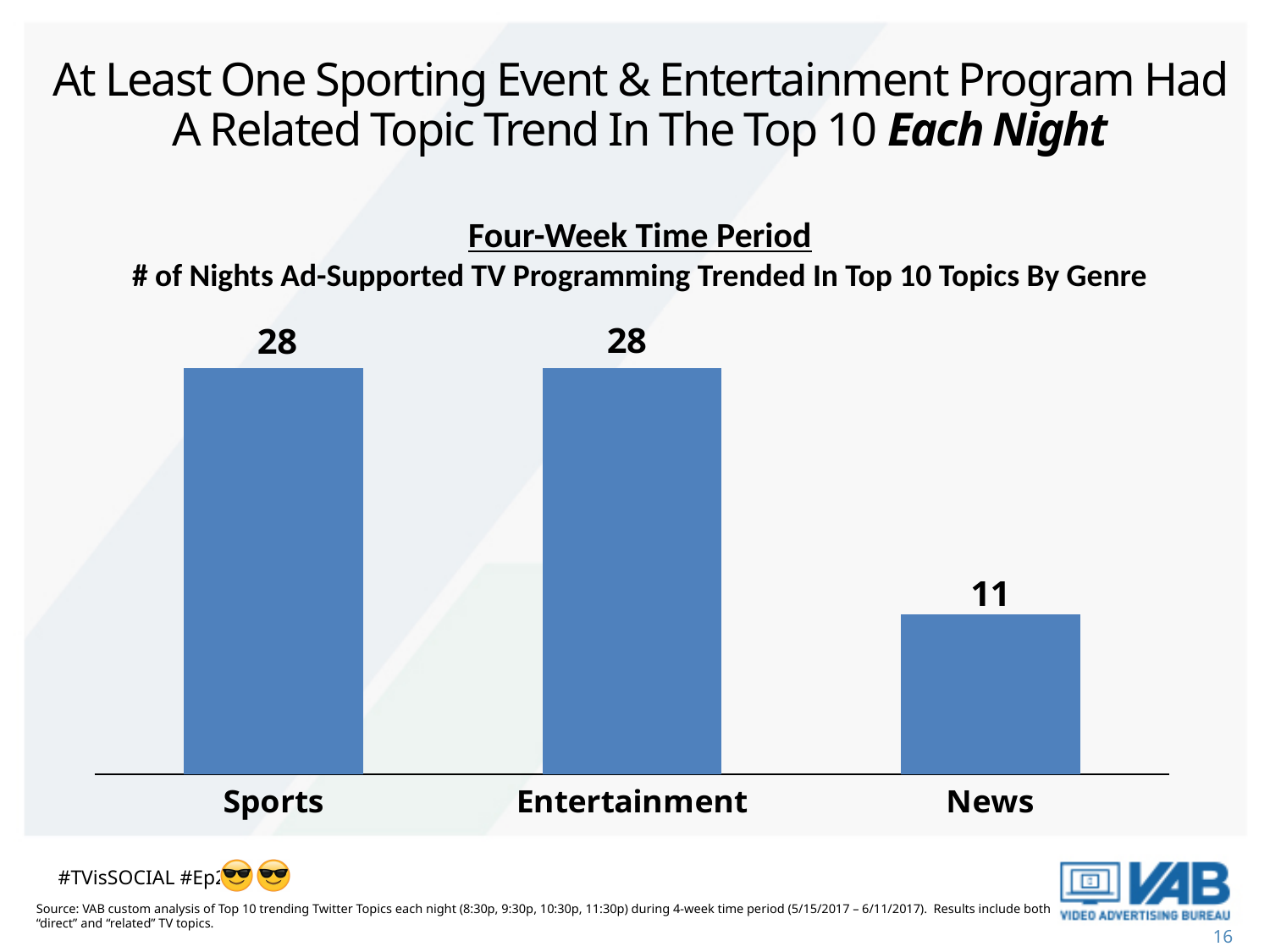
What is the value for News? 11 What is the value for Sports? 28 How many categories are shown in the chart? 3 What is the difference between the values for Sports and News? 17 Which is larger, the value for Entertainment or the value for News? Entertainment What is the value for Entertainment? 28 What is the title of the chart? Four-Week Time Period: # of Nights Ad-Supported TV Programming Trended In Top 10 Topics By Genre Which is larger, the value for Sports or the value for News? Sports What is the difference between the values for Entertainment and News? 17 What kind of chart is shown on the slide? Bar chart Which category has the lowest value? News What colour are the bars in the chart? Blue